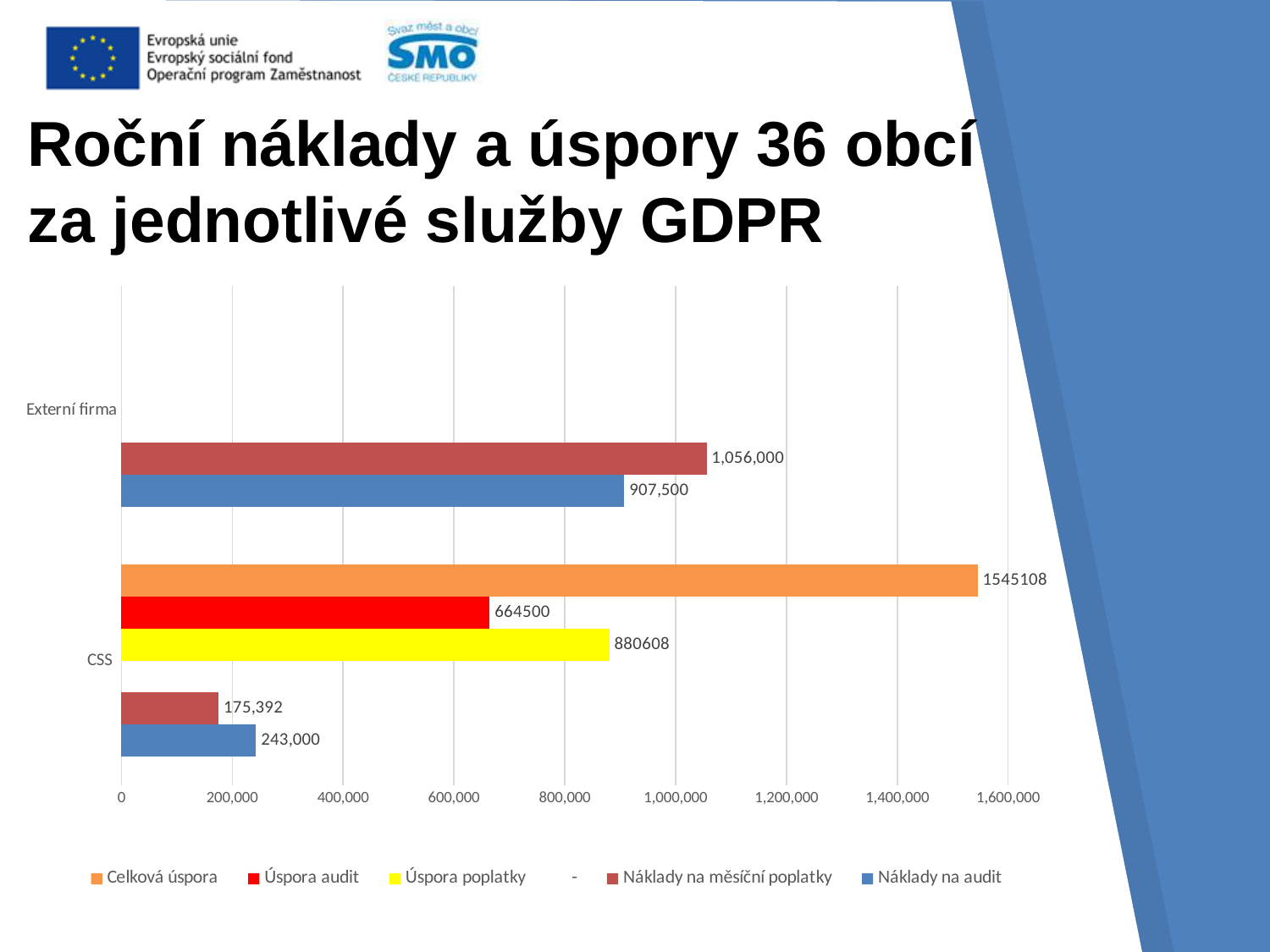
Which bar in the chart has the highest value? Celková úspora for CSS What is the value of Úspora poplatky for CSS? 880608 What is the value of Náklady na audit for CSS? 243,000 Which is larger for CSS: Úspora poplatky or Úspora audit? Úspora poplatky How many categories are shown on the vertical axis of the chart? 2 Which bar in the chart has the lowest value? Náklady na měsíční poplatky for CSS What is the value of Úspora audit for CSS? 664500 What is the value of Celková úspora for CSS? 1545108 What is the difference between Náklady na měsíční poplatky and Náklady na audit for Externí firma? 148,500 What is the value of Náklady na audit for Externí firma? 907,500 What is the value of Náklady na měsíční poplatky for Externí firma? 1,056,000 What type of chart is shown on the slide? bar chart